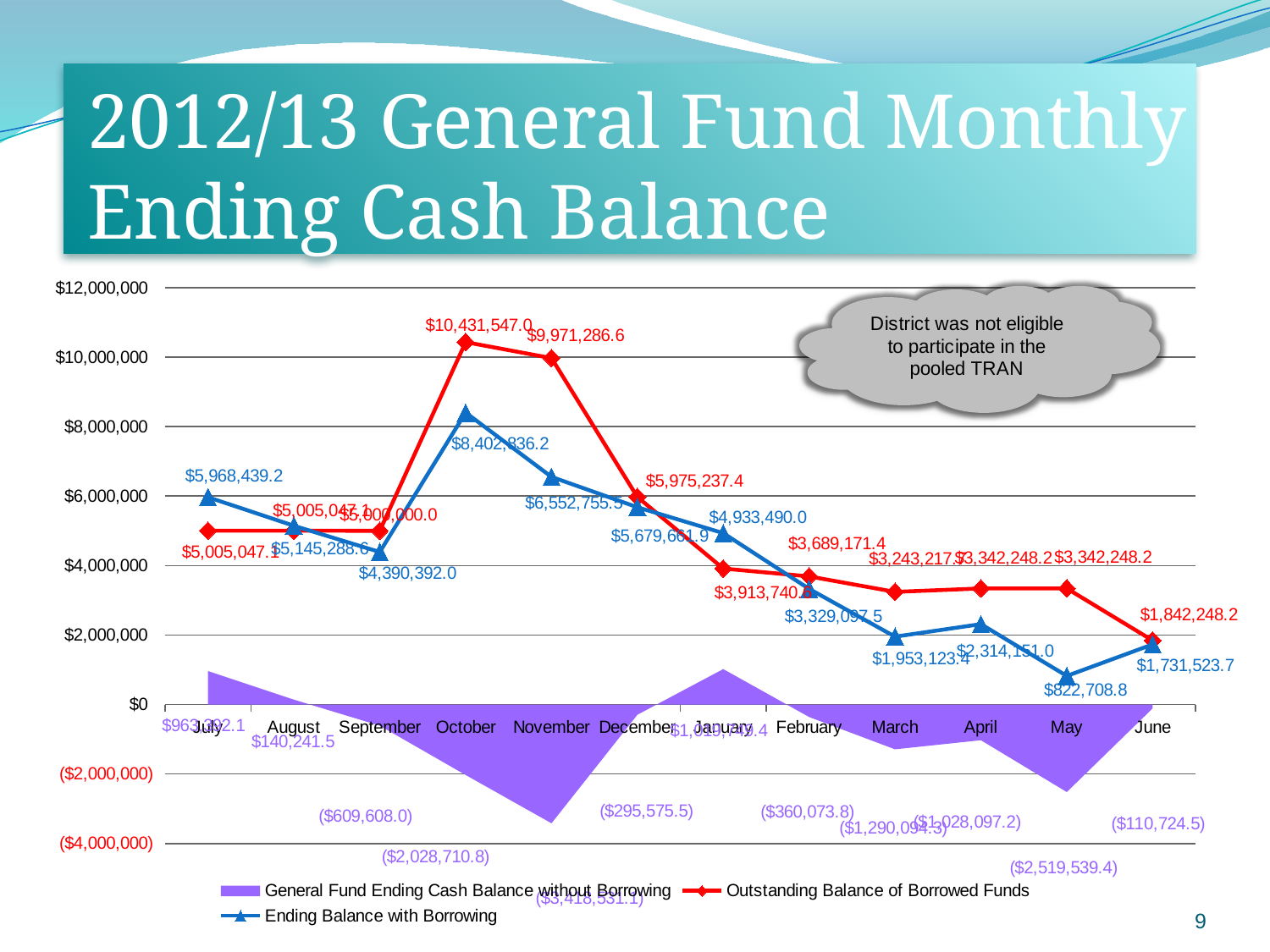
Is the Outstanding Balance of Borrowed Funds in November greater or less than $8,000,000? greater In which month is the Outstanding Balance of Borrowed Funds lowest? June What is the difference between the Outstanding Balance of Borrowed Funds in October and in November? $460,260.4 What is the Outstanding Balance of Borrowed Funds in October? $10,431,547.0 In which month is the Ending Balance with Borrowing highest? October What is the General Fund Ending Cash Balance without Borrowing in April? ($1,028,097.2) How many months are shown on the x axis? 12 Which is larger in December: the Outstanding Balance of Borrowed Funds or the Ending Balance with Borrowing? Outstanding Balance of Borrowed Funds How many series does the legend list? 3 What is the Ending Balance with Borrowing in May? $822,708.8 What does the cloud callout on the chart say? District was not eligible to participate in the pooled TRAN Does the Outstanding Balance of Borrowed Funds rise or fall from October to June? fall